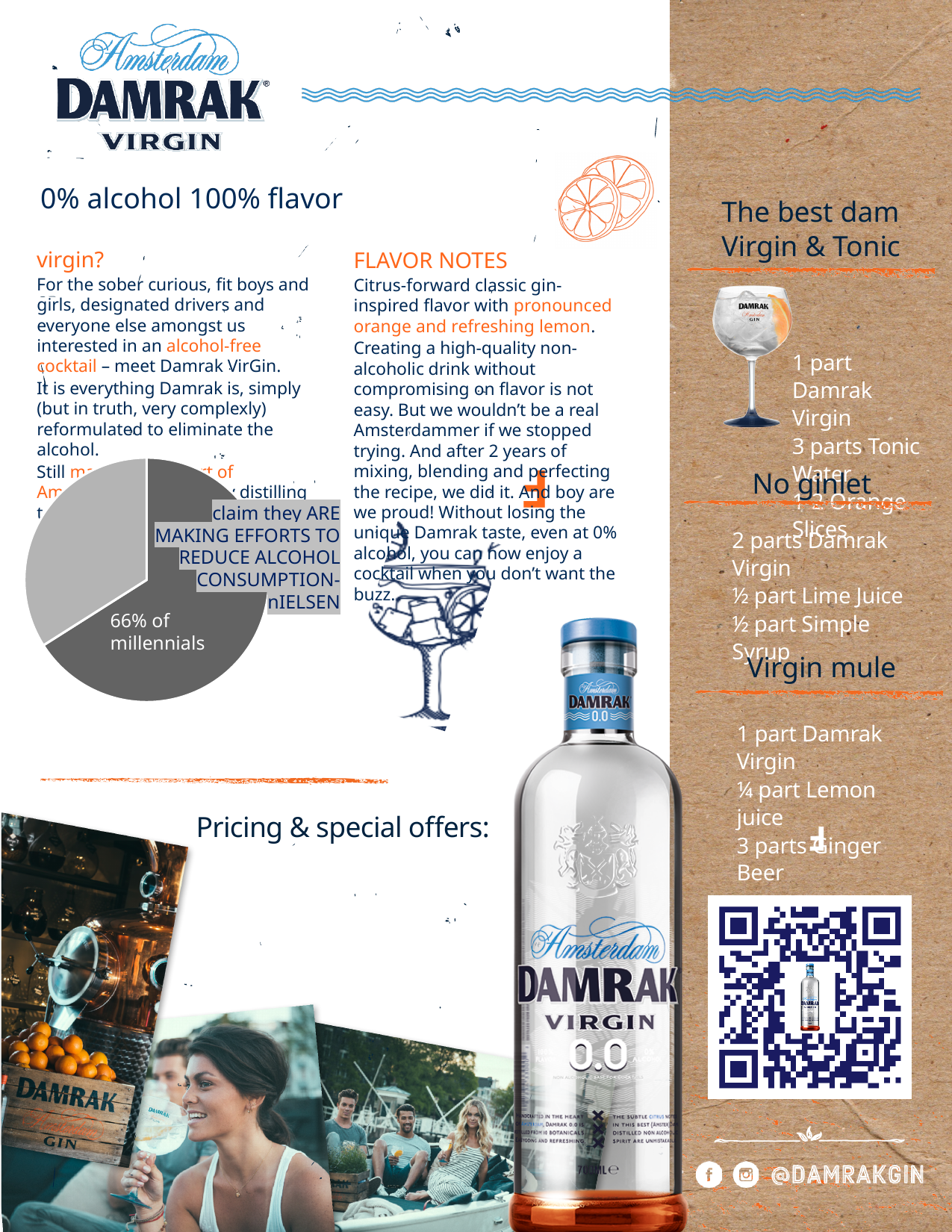
How many slices does the pie chart have? 2 Is the labelled slice of the pie chart greater or less than 50%? greater What kind of chart is shown on the slide? pie chart Which slice of the pie chart is the smallest? the light grey slice According to the text next to the pie chart, what source is cited for the 66% figure? Nielsen What is the data label printed on the larger slice of the pie chart? 66% of millennials Which slice of the pie chart is larger, the dark grey slice or the light grey slice? the dark grey slice What share of millennials does the labelled slice of the pie chart represent? 66% What colour is the slice of the pie chart labelled '66% of millennials'? dark grey